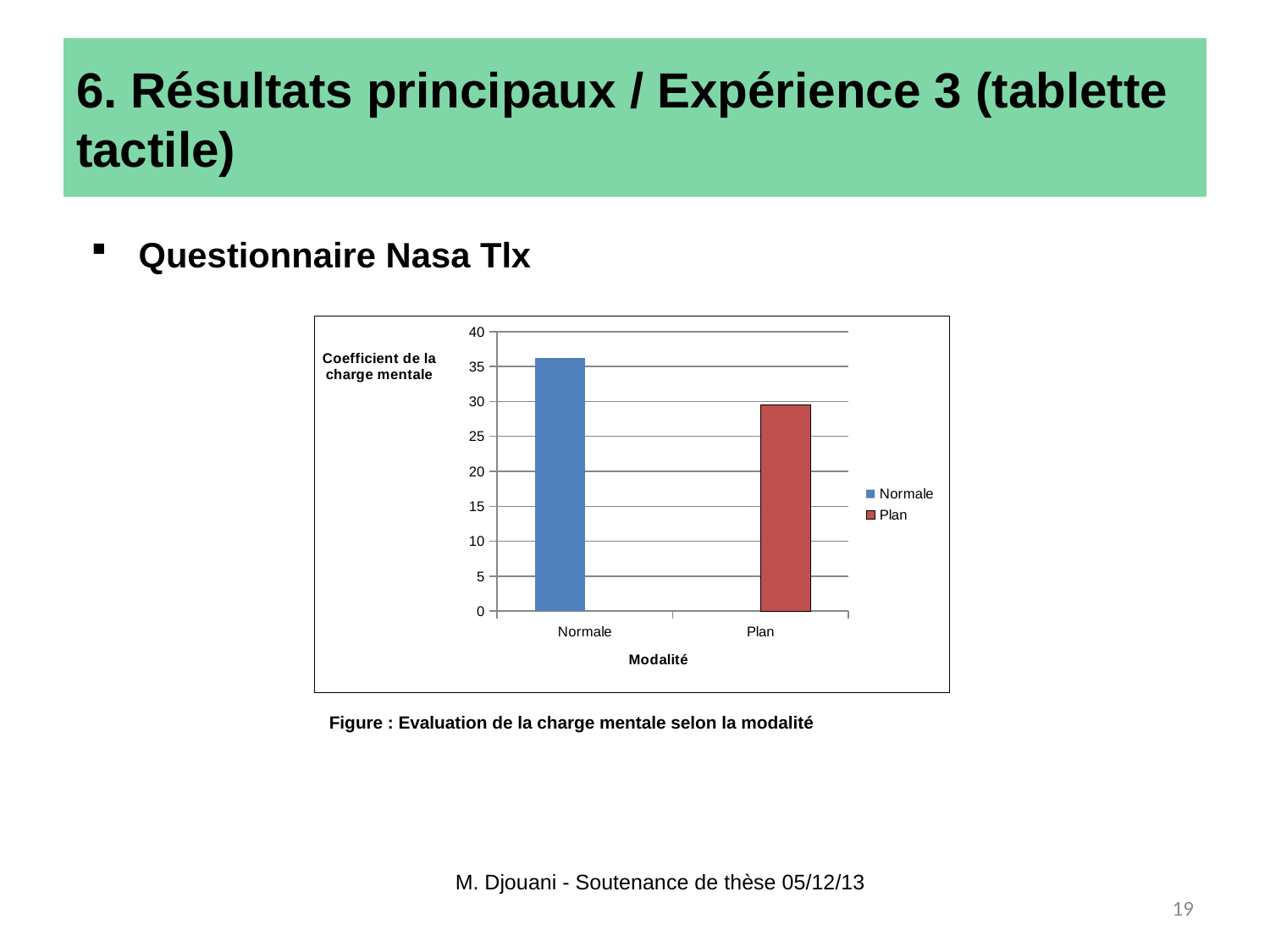
How many series does the legend list? 2 What are the two entries listed in the chart's legend? Normale and Plan Is the value for Normale greater or less than 40? less Is the value for Plan greater or less than 35? less Is the value for Plan greater or less than 25? greater How many bars (categories) are plotted in the chart? 2 Which modality has the lowest coefficient de la charge mentale? Plan Which is larger, the value for Normale or the value for Plan? Normale What kind of chart is shown on the slide? bar chart What is the label of the horizontal axis of the chart? Modalité Which modality has the highest coefficient de la charge mentale? Normale